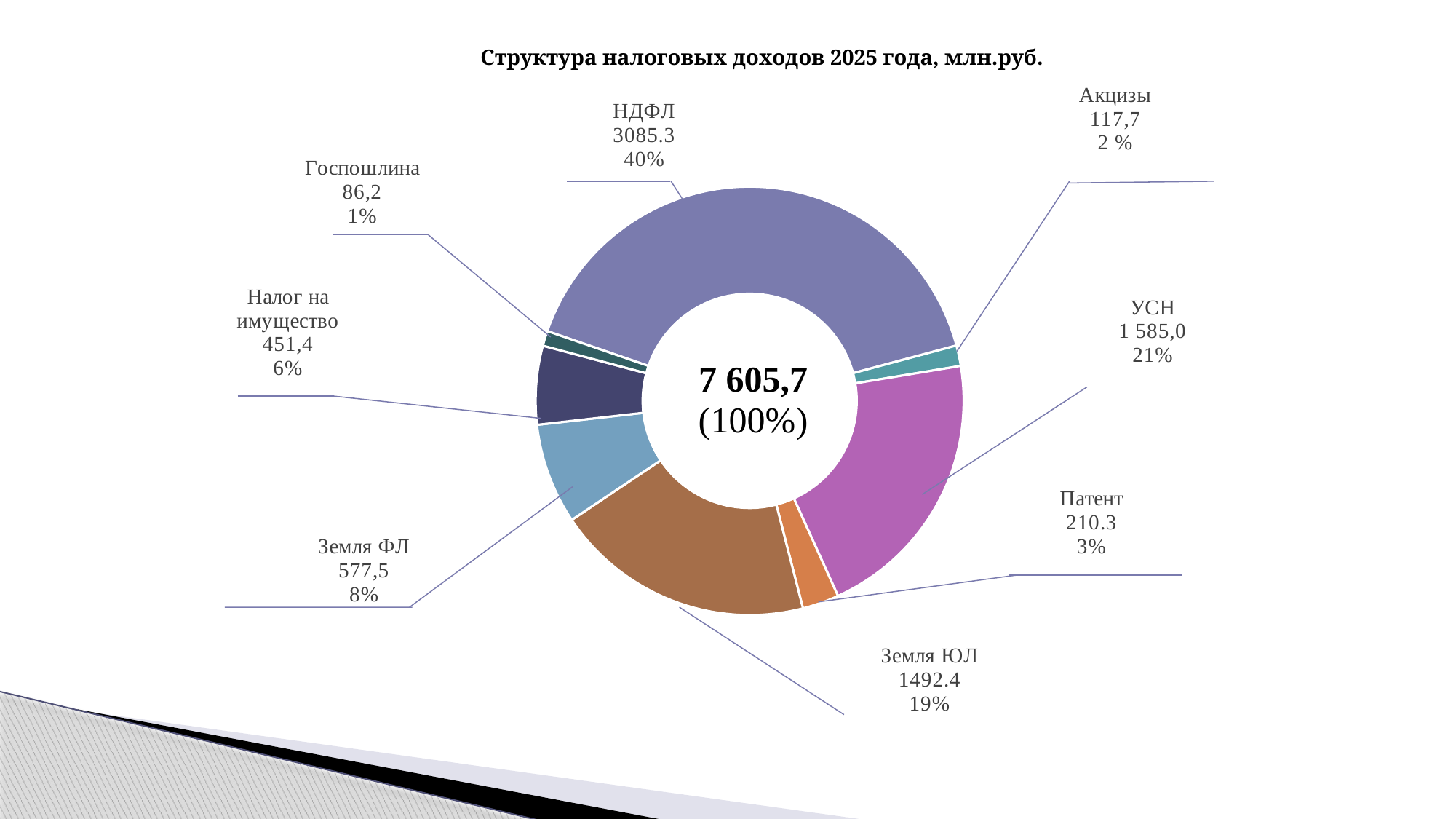
What total value is shown in the centre of the chart? 7 605,7 What is the value for Акцизы? 117,7 What percentage share does Патент have? 3% What is the value for Земля ЮЛ? 1492.4 Which category has the largest share? НДФЛ What is the title of the chart? Структура налоговых доходов 2025 года, млн.руб. Which is larger, Земля ФЛ or Налог на имущество? Земля ФЛ What is the value for НДФЛ? 3085.3 How many categories are shown in the chart? 8 What share of the total does УСН account for? 21% What kind of chart is shown on the slide? Doughnut (pie) chart Which category has the smallest share? Госпошлина